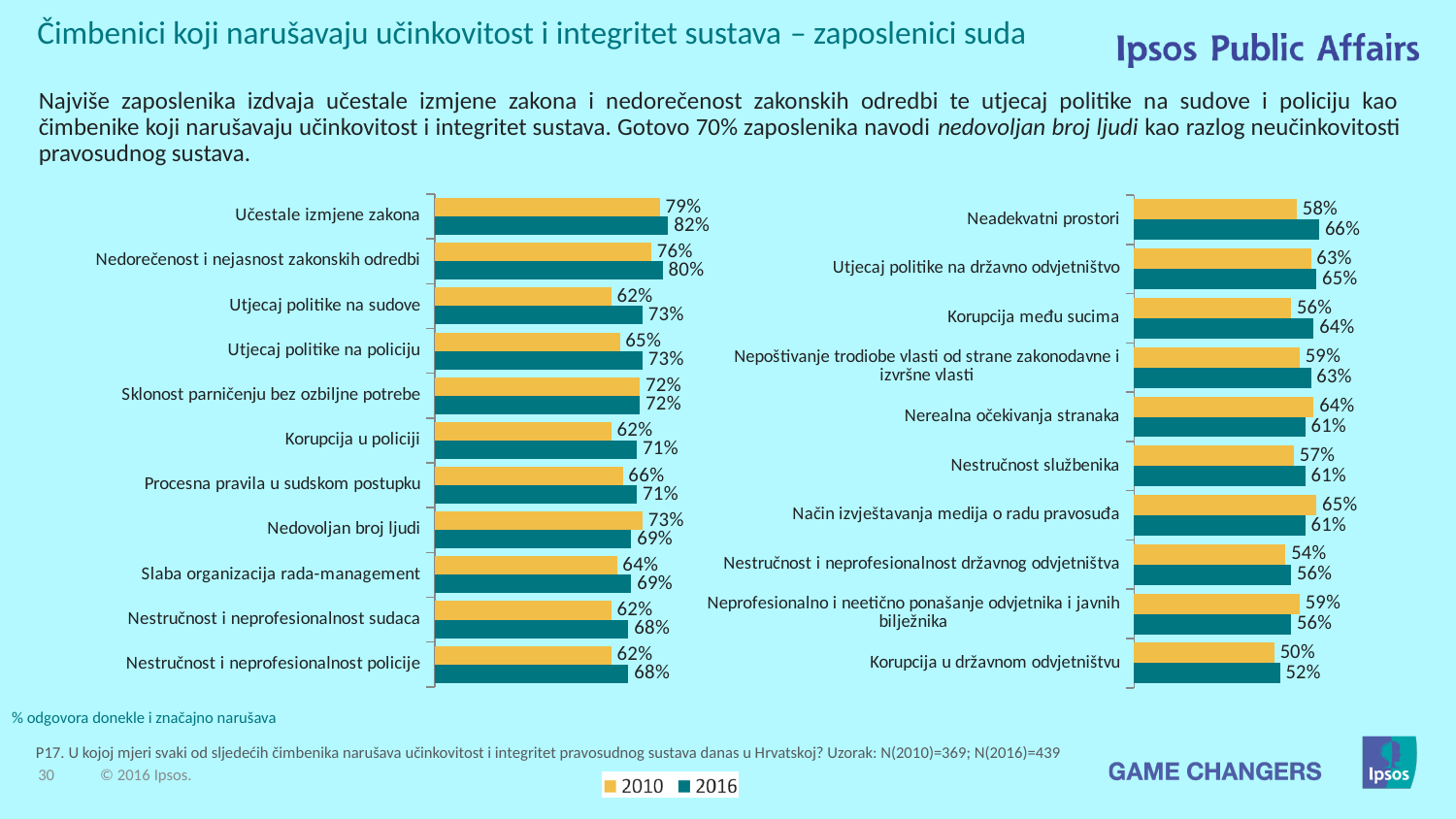
How many categories does the right chart show? 10 In the left chart, which category has the highest 2016 value? Učestale izmjene zakona What type of chart is the right chart? Bar chart How many categories does the left chart show? 11 In the right chart, which category has the lowest 2016 value? Korupcija u državnom odvjetništvu In the left chart, what is the 2016 value for Učestale izmjene zakona? 82% Which colour represents the 2016 series in the charts? Teal How many series does the legend list? 2 In the right chart, which is larger for Nerealna očekivanja stranaka, the 2010 value or the 2016 value? 2010 In the left chart, what is the 2010 value for Nedovoljan broj ljudi? 73% In the right chart, what is the 2016 value for Korupcija među sucima? 64% In the left chart, what is the difference between the 2016 and 2010 values for Utjecaj politike na sudove? 11%